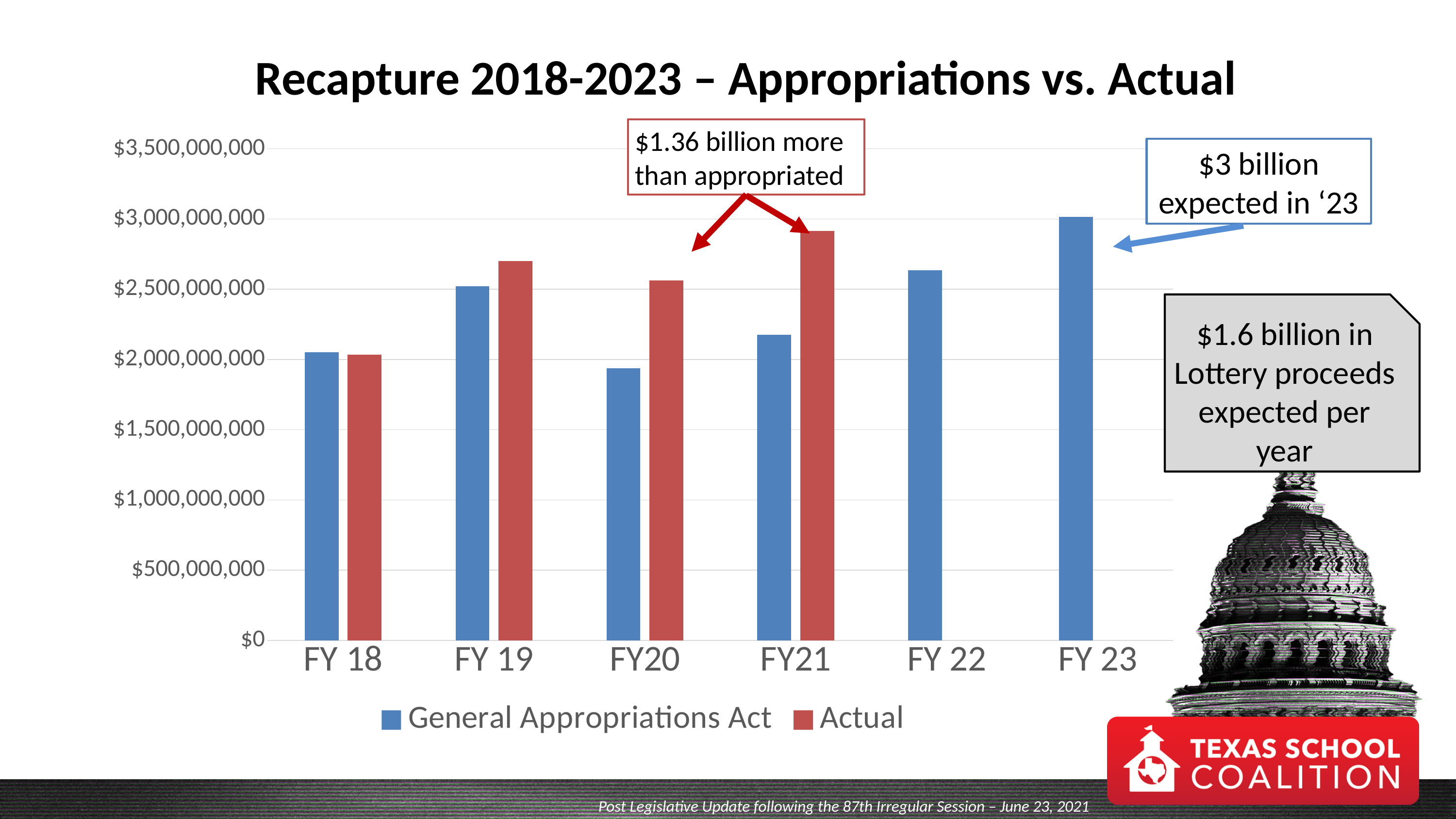
Which fiscal year has the highest Actual bar? FY21 Which fiscal year has the lowest General Appropriations Act bar? FY20 Is the Actual value for FY21 greater or less than $2,500,000,000? greater Is the General Appropriations Act value for FY20 greater or less than $2,000,000,000? less What kind of chart is shown on the slide? bar chart How many fiscal year categories are shown on the x axis? 6 How many series does the legend list? 2 Which fiscal year has the lowest Actual bar? FY 18 What is the title of the chart? Recapture 2018-2023 – Appropriations vs. Actual For FY20, which is larger: the General Appropriations Act value or the Actual value? Actual Which fiscal year has the highest General Appropriations Act bar? FY 23 Do the General Appropriations Act values rise or fall from FY21 to FY 23? rise